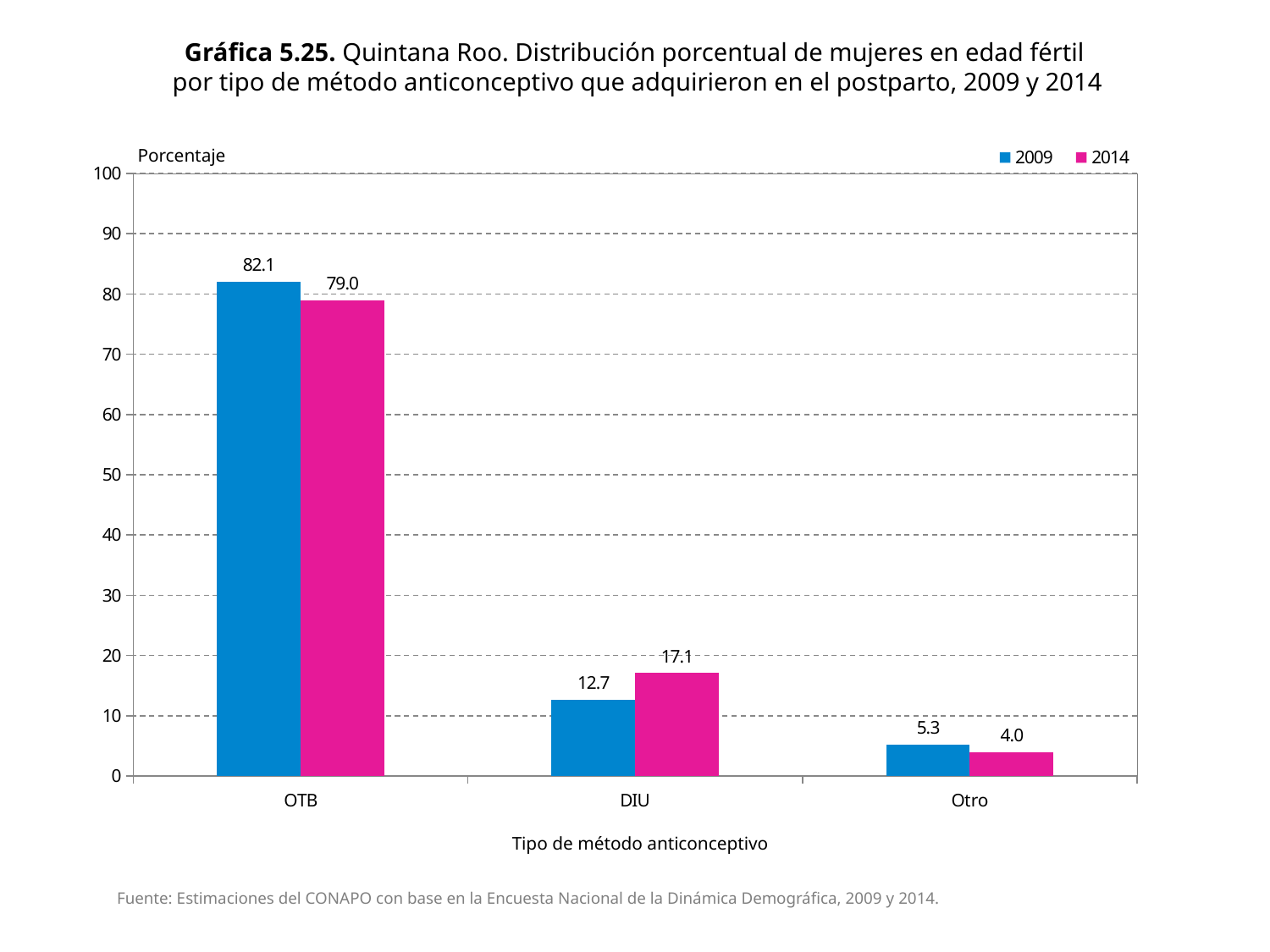
How many categories are shown on the x axis? 3 Is the value for DIU in 2009 greater or less than 20? less How many series does the legend list? 2 What is the difference between the 2009 and 2014 values for OTB? 3.1 What is the value for Otro in 2009? 5.3 What is the difference between the 2014 and 2009 values for DIU? 4.4 Which category has the lowest value in 2009? Otro What kind of chart is shown on the slide? bar chart What is the value for DIU in 2014? 17.1 Which category has the highest value in 2014? OTB Which is larger for Otro: the 2009 value or the 2014 value? 2009 What is the value for OTB in 2009? 82.1